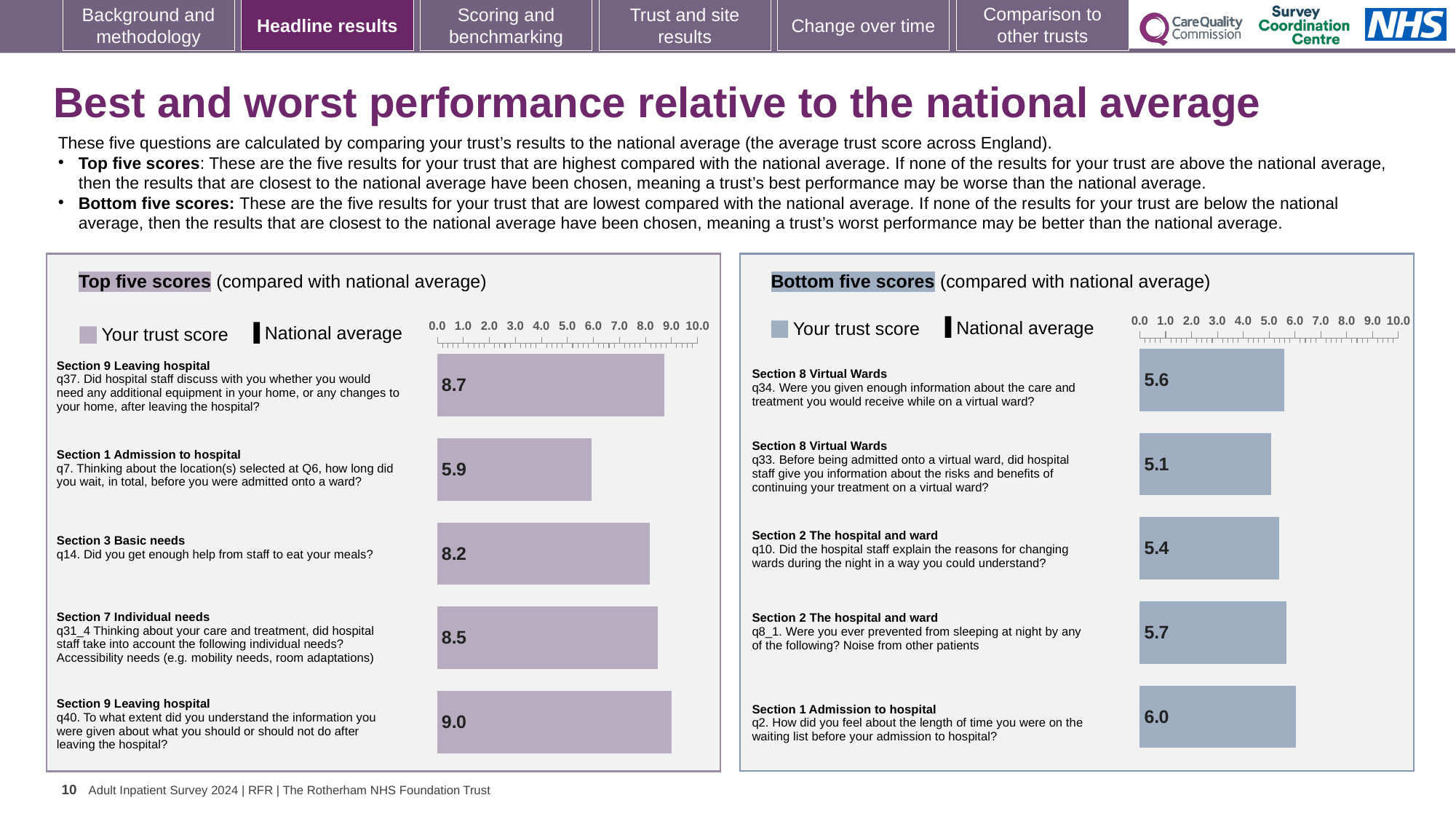
In the Bottom five scores chart, what is the trust score for q2 about the length of time on the waiting list before admission? 6.0 In the Bottom five scores chart, what is the difference between the trust scores for q2 and q33? 0.9 In the Bottom five scores chart, which question has the lowest trust score? q33 In the Top five scores chart, which question has the lowest trust score? q7 In the Top five scores chart, which question has the highest trust score? q40 What kind of chart is the Bottom five scores chart? Bar chart How many bars are plotted in the Top five scores chart? 5 In the Bottom five scores chart, which is larger, the trust score for q34 or for q10? q34 In the Top five scores chart, what is the difference between the trust scores for q40 and q7? 3.1 In the Top five scores chart, what is the trust score for q37 about discussing additional equipment or changes to your home after leaving hospital? 8.7 In the Top five scores chart, what is the trust score for q14 about getting enough help from staff to eat your meals? 8.2 In the Bottom five scores chart, what is the trust score for q33 about information on the risks and benefits of continuing treatment on a virtual ward? 5.1